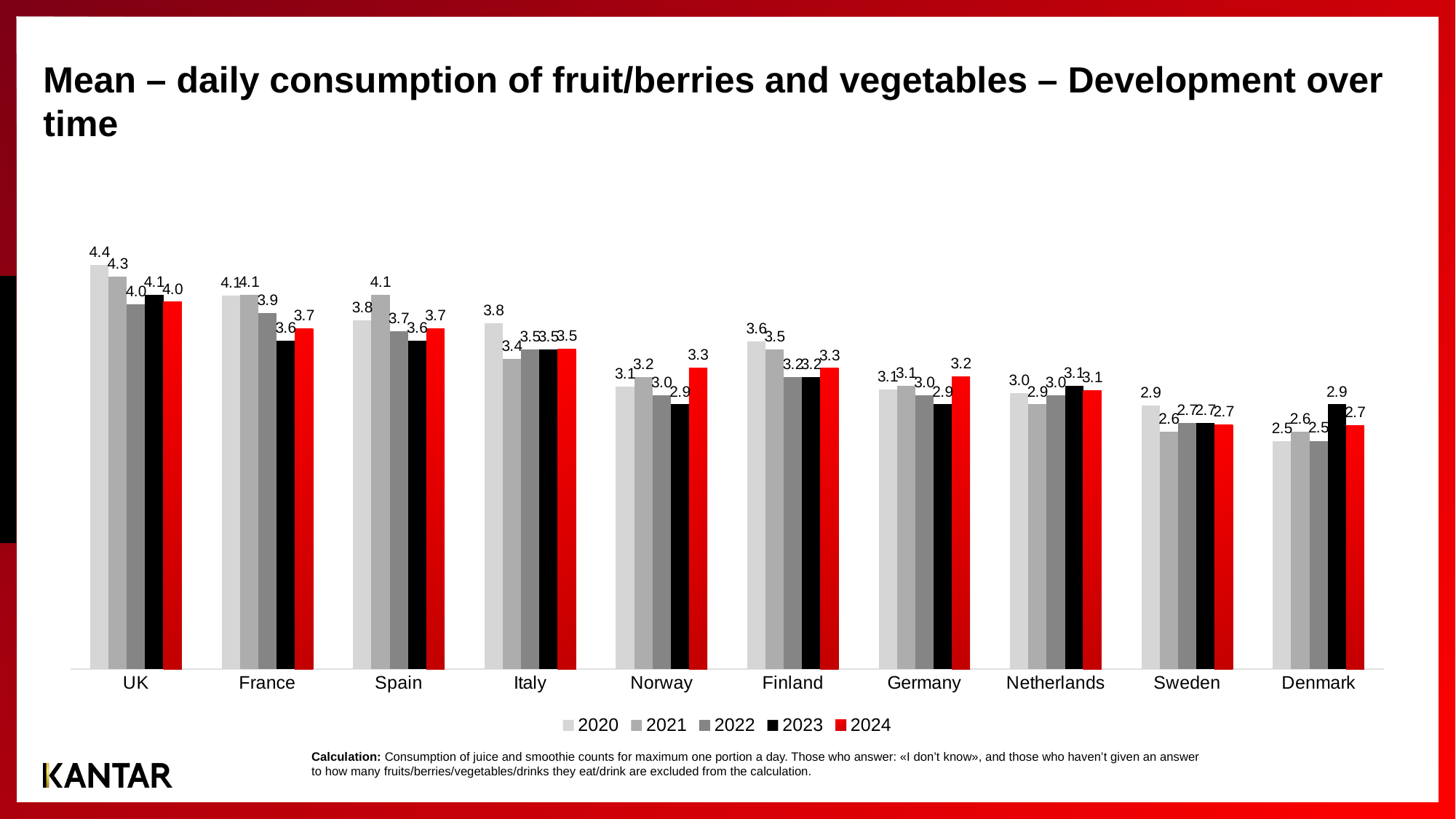
What is the 2021 value for Spain? 4.1 How many series does the legend list? 5 Which colour represents the 2024 series in the legend? Red What is the 2020 value for Finland? 3.6 Which country has the lowest 2024 value? Sweden and Denmark (both 2.7) Which country has the highest 2020 value? UK What is the 2024 value for the UK? 4.0 Which is larger for Norway: the 2023 value or the 2024 value? 2024 What kind of chart is shown on the slide? Bar chart What is the 2023 value for Denmark? 2.9 What is the difference between the 2020 and 2024 values for France? 0.4 How many countries are shown on the x axis? 10